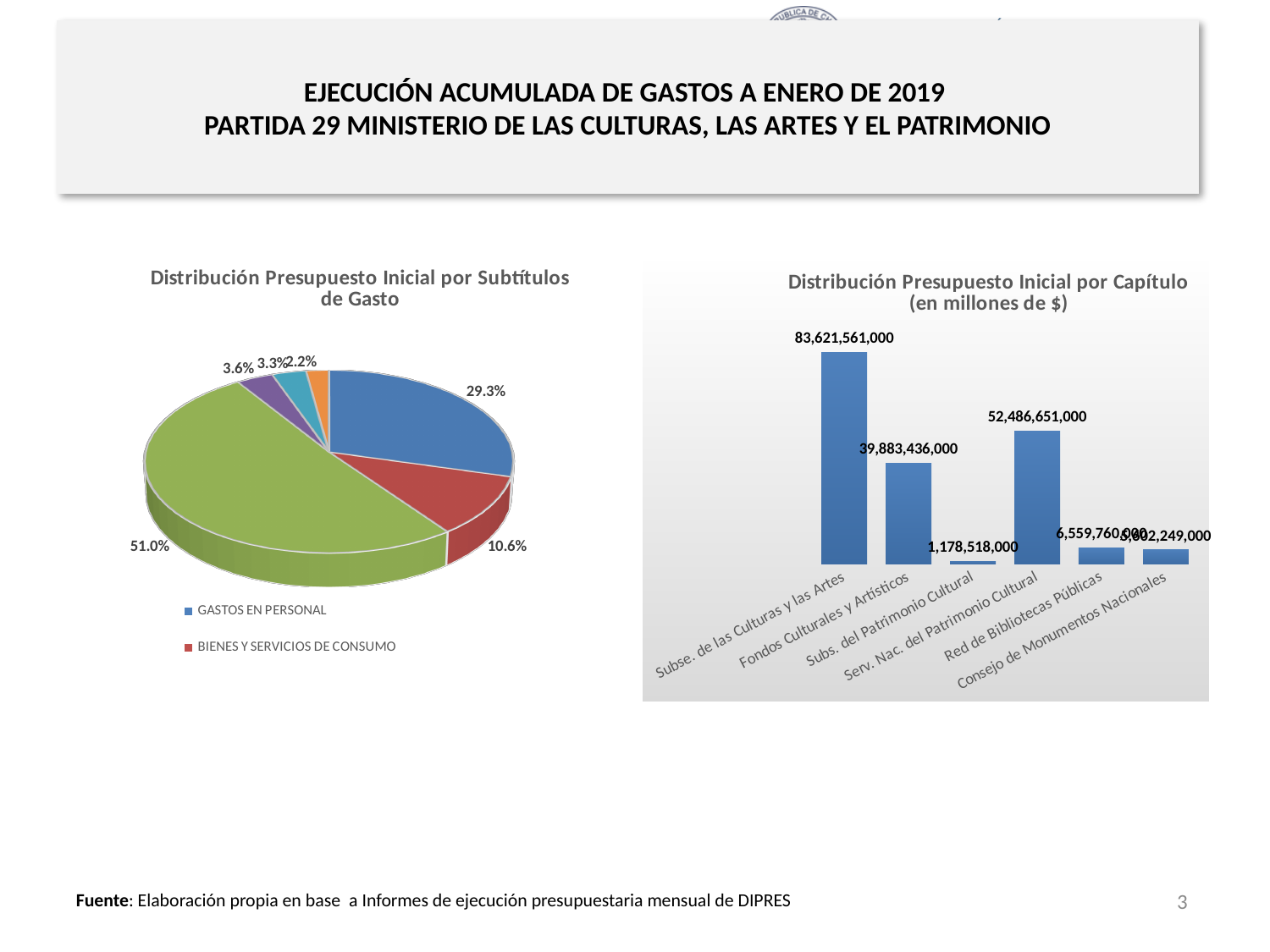
In the pie chart 'Distribución Presupuesto Inicial por Subtítulos de Gasto', what is the percentage of the smallest slice? 2.2% In the chart 'Distribución Presupuesto Inicial por Capítulo', what is the value for Fondos Culturales y Artísticos? 39,883,436,000 In the pie chart 'Distribución Presupuesto Inicial por Subtítulos de Gasto', what share does GASTOS EN PERSONAL have? 29.3% In the pie chart 'Distribución Presupuesto Inicial por Subtítulos de Gasto', how many percentage points larger is GASTOS EN PERSONAL than BIENES Y SERVICIOS DE CONSUMO? 18.7 How many slices does the pie chart 'Distribución Presupuesto Inicial por Subtítulos de Gasto' have? 6 In the pie chart 'Distribución Presupuesto Inicial por Subtítulos de Gasto', what is the percentage of the largest slice? 51.0% In the chart 'Distribución Presupuesto Inicial por Capítulo', which category has the lowest value? Subs. del Patrimonio Cultural In the chart 'Distribución Presupuesto Inicial por Capítulo', what is the value for Subse. de las Culturas y las Artes? 83,621,561,000 What kind of chart is 'Distribución Presupuesto Inicial por Capítulo'? Bar chart In the pie chart 'Distribución Presupuesto Inicial por Subtítulos de Gasto', what share does BIENES Y SERVICIOS DE CONSUMO have? 10.6% In the chart 'Distribución Presupuesto Inicial por Capítulo', what is the value for Serv. Nac. del Patrimonio Cultural? 52,486,651,000 In the chart 'Distribución Presupuesto Inicial por Capítulo', which is larger: Fondos Culturales y Artísticos or Serv. Nac. del Patrimonio Cultural? Serv. Nac. del Patrimonio Cultural